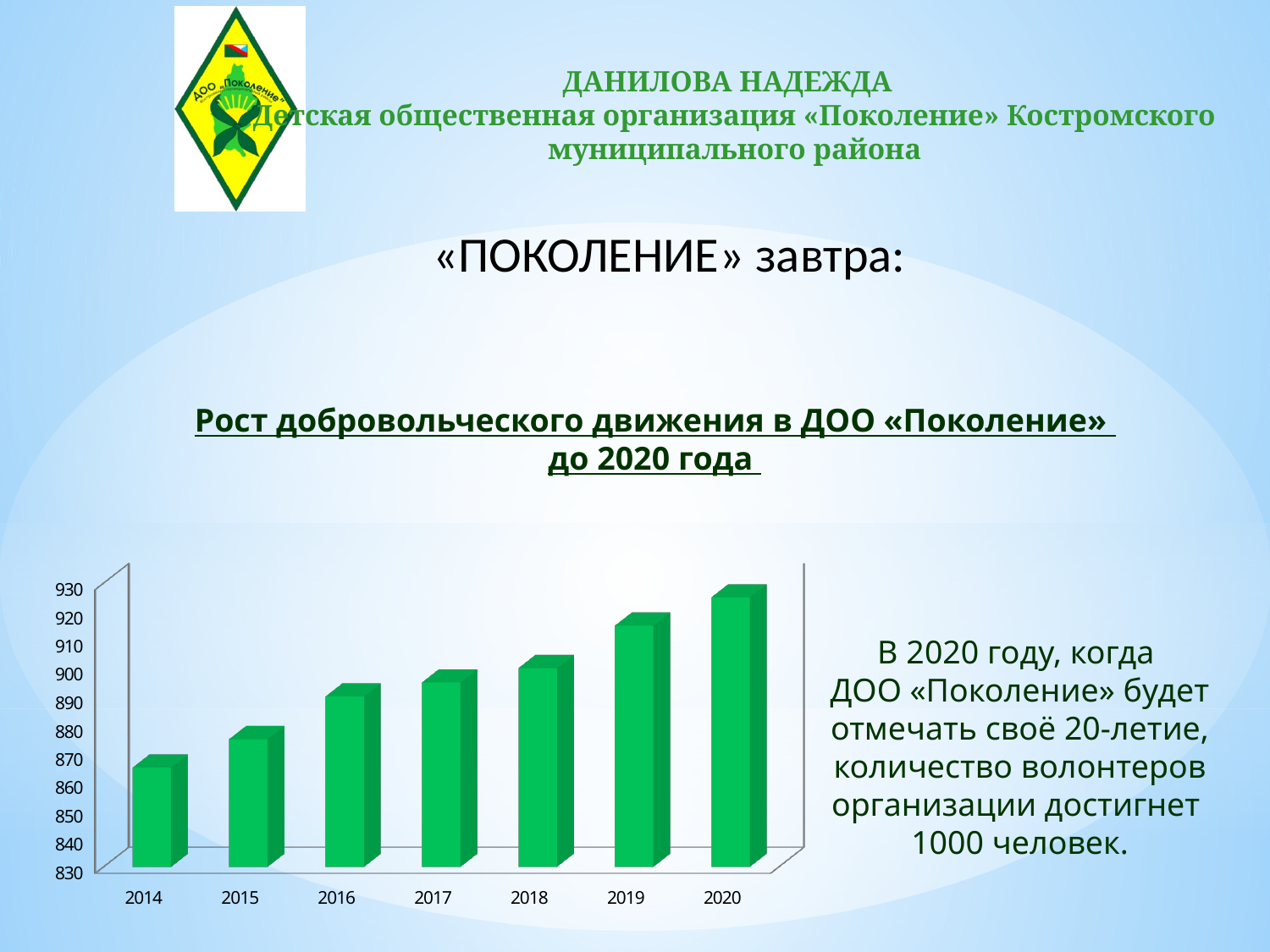
Which is larger, the value for 2019 or the value for 2015? 2019 Is the value for 2016 greater or less than 900? less How many years are shown on the x axis of the chart? 7 Do the values rise or fall from 2014 to 2020? Rise Is the value for 2014 greater or less than 880? less What is the title of the chart? Рост добровольческого движения в ДОО «Поколение» до 2020 года Which year has the lowest bar in the chart? 2014 Is the value for 2020 greater or less than 910? greater Which year has the highest bar in the chart? 2020 Which is larger, the value for 2014 or the value for 2017? 2017 What kind of chart is shown on the slide? Bar chart